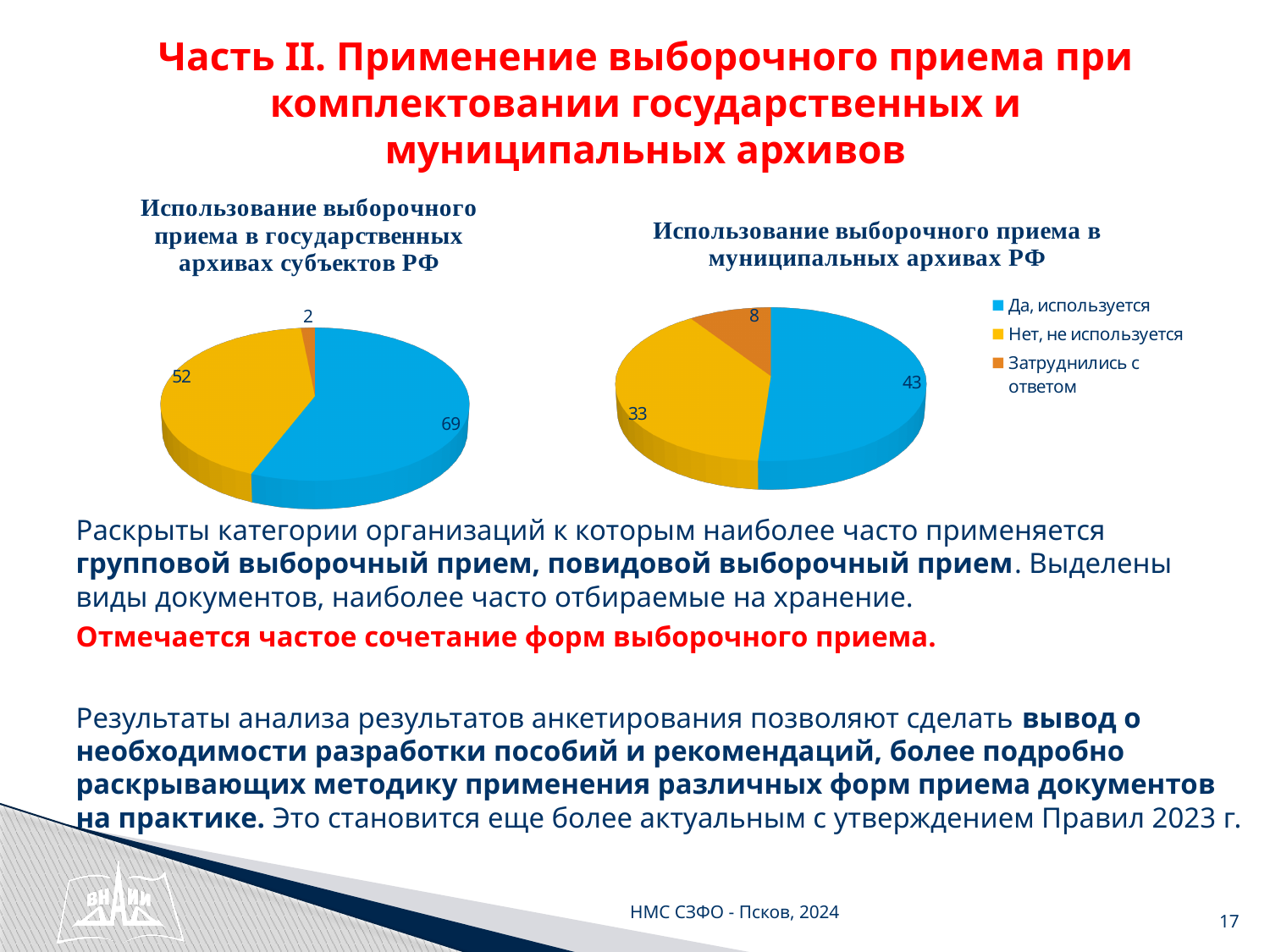
In the chart 'Использование выборочного приема в муниципальных архивах РФ', what is the value for 'Да, используется'? 43 In the chart 'Использование выборочного приема в муниципальных архивах РФ', which category has the smallest slice? Затруднились с ответом Which is larger: 'Нет, не используется' in the left chart (государственных архивах) or 'Нет, не используется' in the right chart (муниципальных архивах)? Left chart (52) In the chart 'Использование выборочного приема в муниципальных архивах РФ', what is the difference between 'Да, используется' and 'Нет, не используется'? 10 In the chart 'Использование выборочного приема в государственных архивах субъектов РФ', which category has the largest slice? Да, используется What type of chart is used on this slide? Pie chart In the chart 'Использование выборочного приема в государственных архивах субъектов РФ', what is the value for 'Нет, не используется'? 52 In the chart 'Использование выборочного приема в государственных архивах субъектов РФ', what is the value for 'Да, используется'? 69 How many entries does the legend list? 3 In the chart 'Использование выборочного приема в муниципальных архивах РФ', what is the value for 'Затруднились с ответом'? 8 In the chart 'Использование выборочного приема в государственных архивах субъектов РФ', what is the value for 'Затруднились с ответом'? 2 In the chart 'Использование выборочного приема в государственных архивах субъектов РФ', what is the difference between 'Да, используется' and 'Нет, не используется'? 17